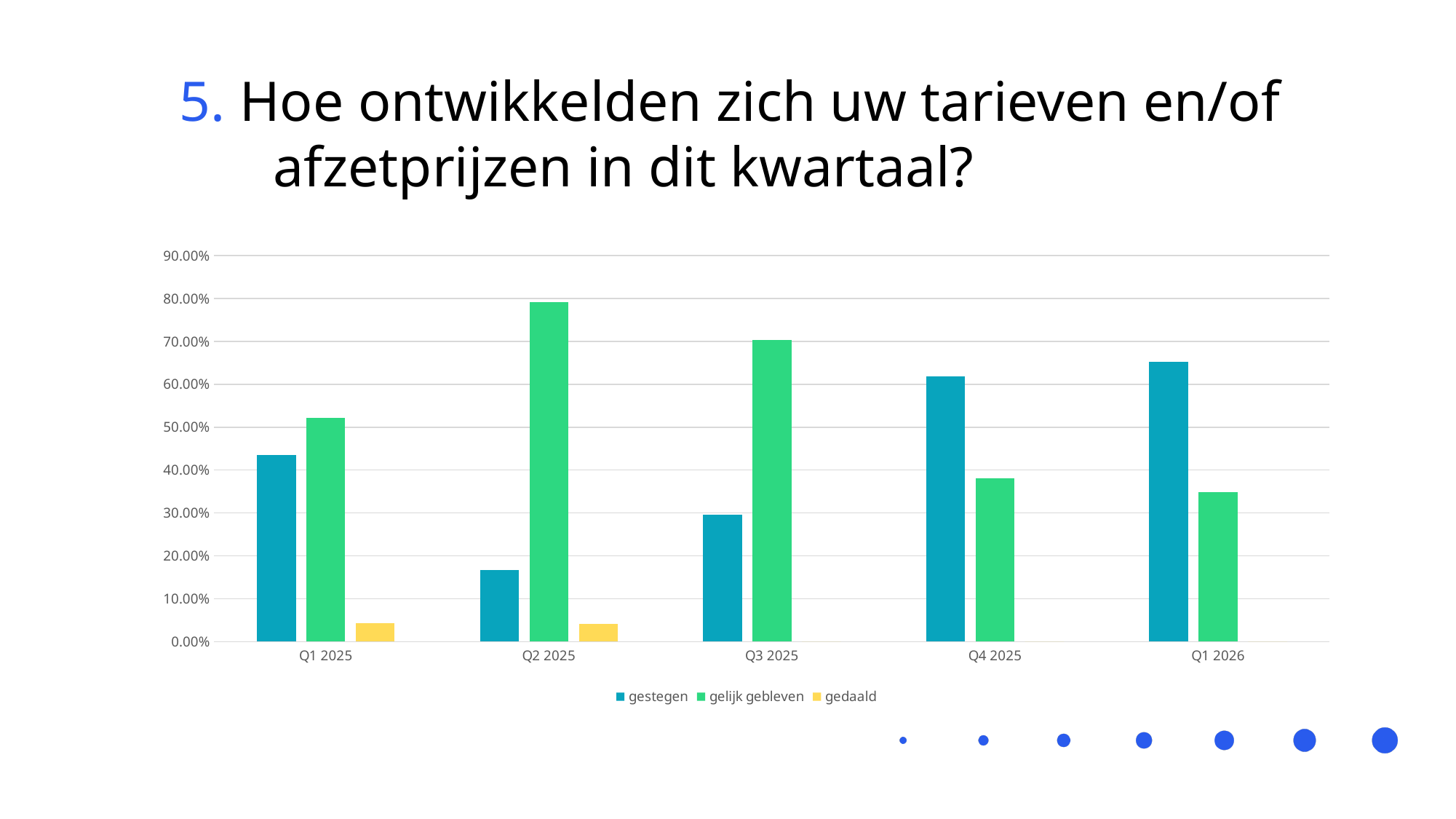
In which quarter is the value for 'gestegen' highest? Q1 2026 Is the value for 'gelijk gebleven' in Q2 2025 greater or less than 70%? greater In Q4 2025, which is larger: 'gestegen' or 'gelijk gebleven'? gestegen Does the value for 'gelijk gebleven' rise or fall from Q2 2025 to Q1 2026? fall In which quarter is the value for 'gelijk gebleven' highest? Q2 2025 Is the value for 'gestegen' in Q3 2025 greater or less than 40%? less In which quarter is the value for 'gestegen' lowest? Q2 2025 In Q1 2025, which is larger: 'gestegen' or 'gelijk gebleven'? gelijk gebleven What kind of chart is shown on the slide? bar chart How many quarters are shown on the x axis? 5 Is the value for 'gestegen' in Q2 2025 greater or less than 20%? less How many series does the legend list? 3